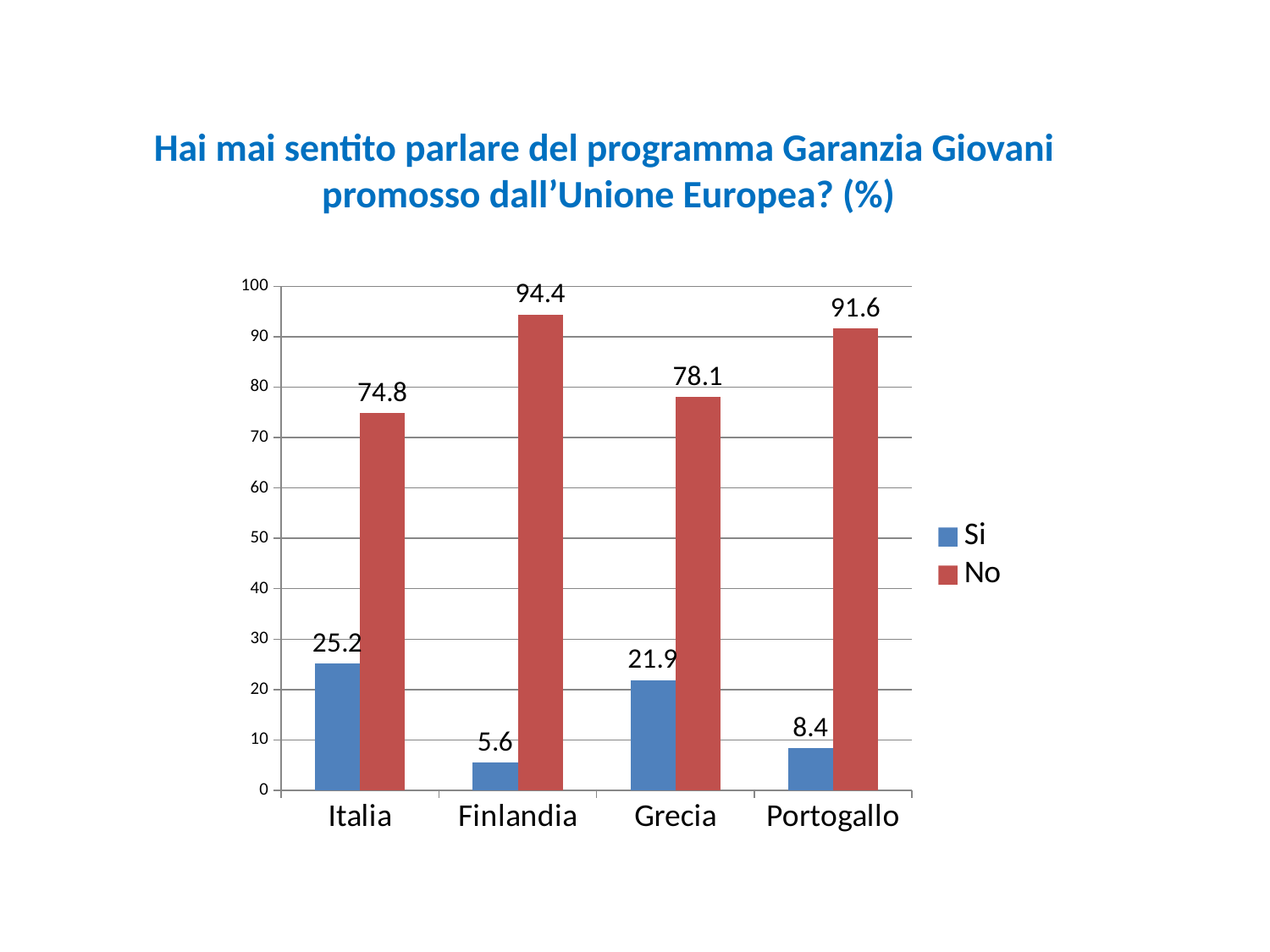
Which country has the lowest value for Si? Finlandia What is the value for No in Grecia? 78.1 What is the value for No in Finlandia? 94.4 What is the difference between the No value for Portogallo and the No value for Italia? 16.8 How many countries are shown on the x axis? 4 What is the value for Si in Portogallo? 8.4 Which is larger, the Si value for Italia or the Si value for Grecia? Italia How many series does the legend list? 2 What is the value for Si in Italia? 25.2 Which country has the highest value for No? Finlandia Is the value for No in Grecia greater or less than 70? greater What kind of chart is shown on the slide? Bar chart